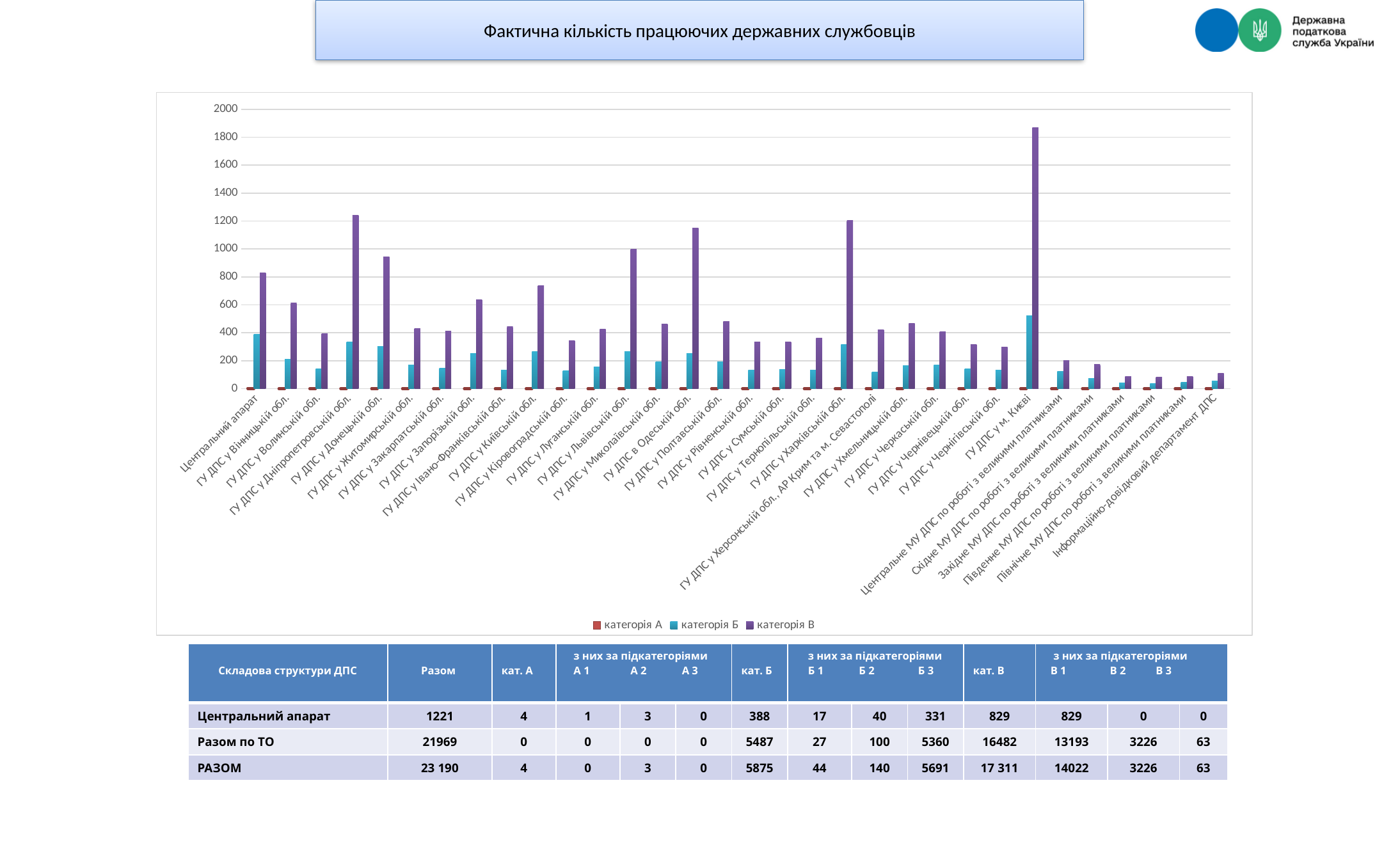
What kind of chart is shown on the slide? bar chart Is the категорія В value for ГУ ДПС в Одеській обл. greater or less than 1000? greater How many series does the chart legend list? 3 Which has the larger категорія В value: ГУ ДПС у Дніпропетровській обл. or ГУ ДПС у Донецькій обл.? ГУ ДПС у Дніпропетровській обл. What is the title shown above the chart? Фактична кількість працюючих державних службовців How many categories are shown along the x axis of the chart? 32 Which category has the highest value for категорія В? ГУ ДПС у м. Києві Which has the larger категорія В value: ГУ ДПС у Київській обл. or ГУ ДПС у Запорізькій обл.? ГУ ДПС у Київській обл. Which category has the highest value for категорія Б? ГУ ДПС у м. Києві What are the three series named in the chart legend? категорія А, категорія Б, категорія В Is the категорія В value for ГУ ДПС у Донецькій обл. greater or less than 1000? less Is the категорія В value for ГУ ДПС у м. Києві greater or less than 1800? greater